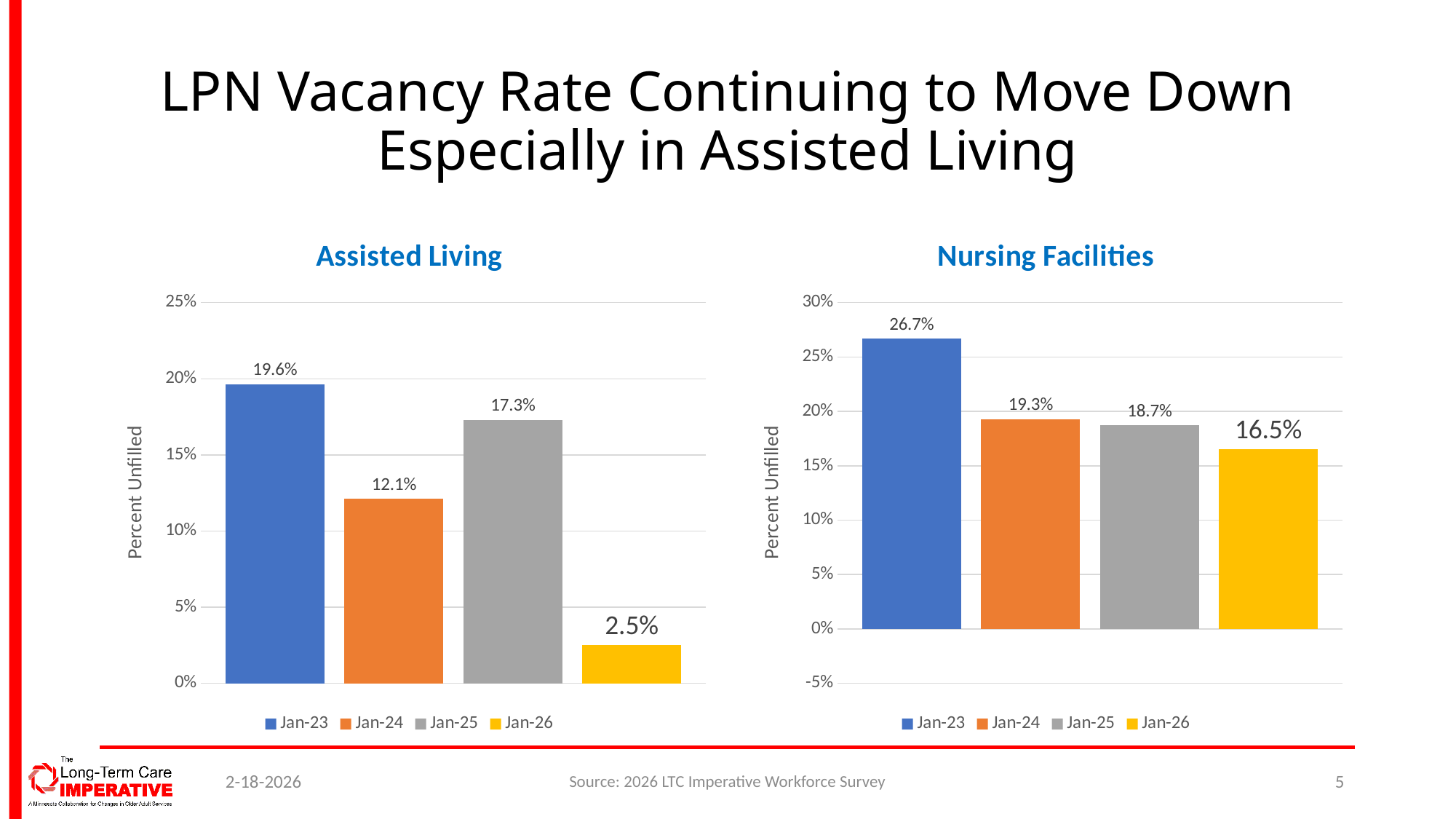
How many series does the legend of the Nursing Facilities chart list? 4 What kind of chart is the Assisted Living chart? bar chart In the Assisted Living chart, which year has the highest vacancy rate? Jan-23 In the Assisted Living chart, what is the difference between the Jan-25 and Jan-26 values? 14.8% In the Nursing Facilities chart, what is the difference between the Jan-23 and Jan-24 values? 7.4% In the Assisted Living chart, what is the value for Jan-24? 12.1% In the Nursing Facilities chart, is the value for Jan-23 greater or less than 25%? greater In the Assisted Living chart, what is the LPN vacancy rate for Jan-26? 2.5% In the Nursing Facilities chart, do the values rise or fall from Jan-23 to Jan-26? fall In the Assisted Living chart, which is larger, the Jan-24 value or the Jan-25 value? Jan-25 In the Nursing Facilities chart, what is the LPN vacancy rate for Jan-23? 26.7% In the Nursing Facilities chart, which year has the lowest vacancy rate? Jan-26